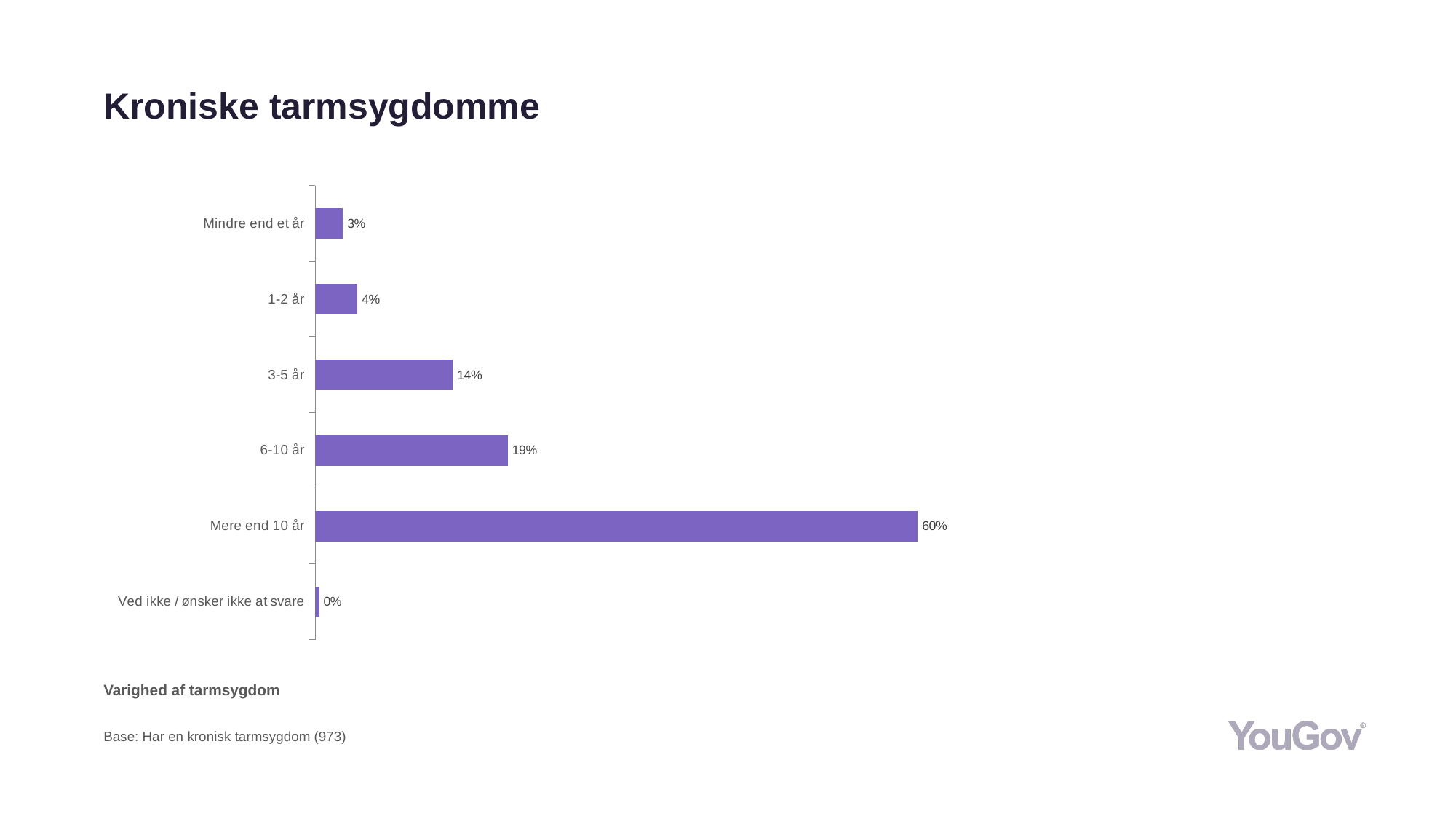
What is the value for "3-5 år"? 14% What is the difference between the values for "3-5 år" and "1-2 år"? 10% Which category has the highest value? Mere end 10 år What is the value for "Mindre end et år"? 3% Which category has the lowest value? Ved ikke / ønsker ikke at svare Which is larger, the value for "6-10 år" or the value for "3-5 år"? 6-10 år What is the value for "Mere end 10 år"? 60% What is the title of the slide? Kroniske tarmsygdomme What kind of chart is shown on the slide? Bar chart What is the difference between the values for "Mere end 10 år" and "6-10 år"? 41% What is the value for "6-10 år"? 19% How many categories are shown in the chart? 6